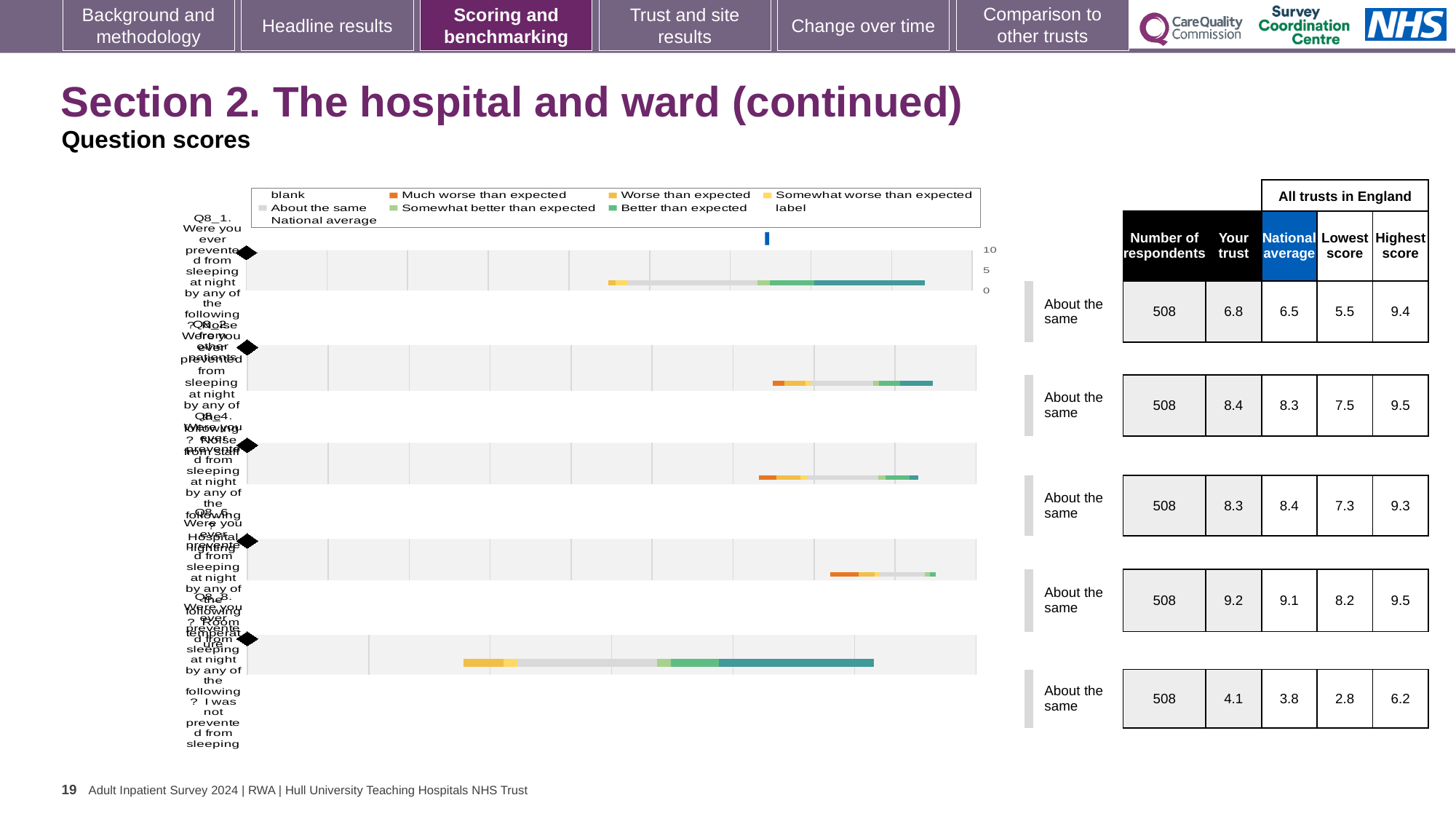
What is the difference between the 'Your trust' score and the national average for Q8_1? 0.3 Which question has the lowest 'Your trust' score? Q8_8 What is the national average score for Q8_8? 3.8 What is the 'Your trust' score for Q8_1? 6.8 For Q8_4, which is larger: the 'Your trust' score or the national average? National average Which question has the highest 'Your trust' score? Q8_6 How many question rows (bars) are plotted in the chart? 5 What is the highest score among all trusts in England for Q8_2? 9.5 What benchmark category is shown for Q8_8? About the same What kind of chart is shown on the slide? bar chart How many respondents are listed for Q8_6? 508 What is the lowest score among all trusts in England for Q8_6? 8.2